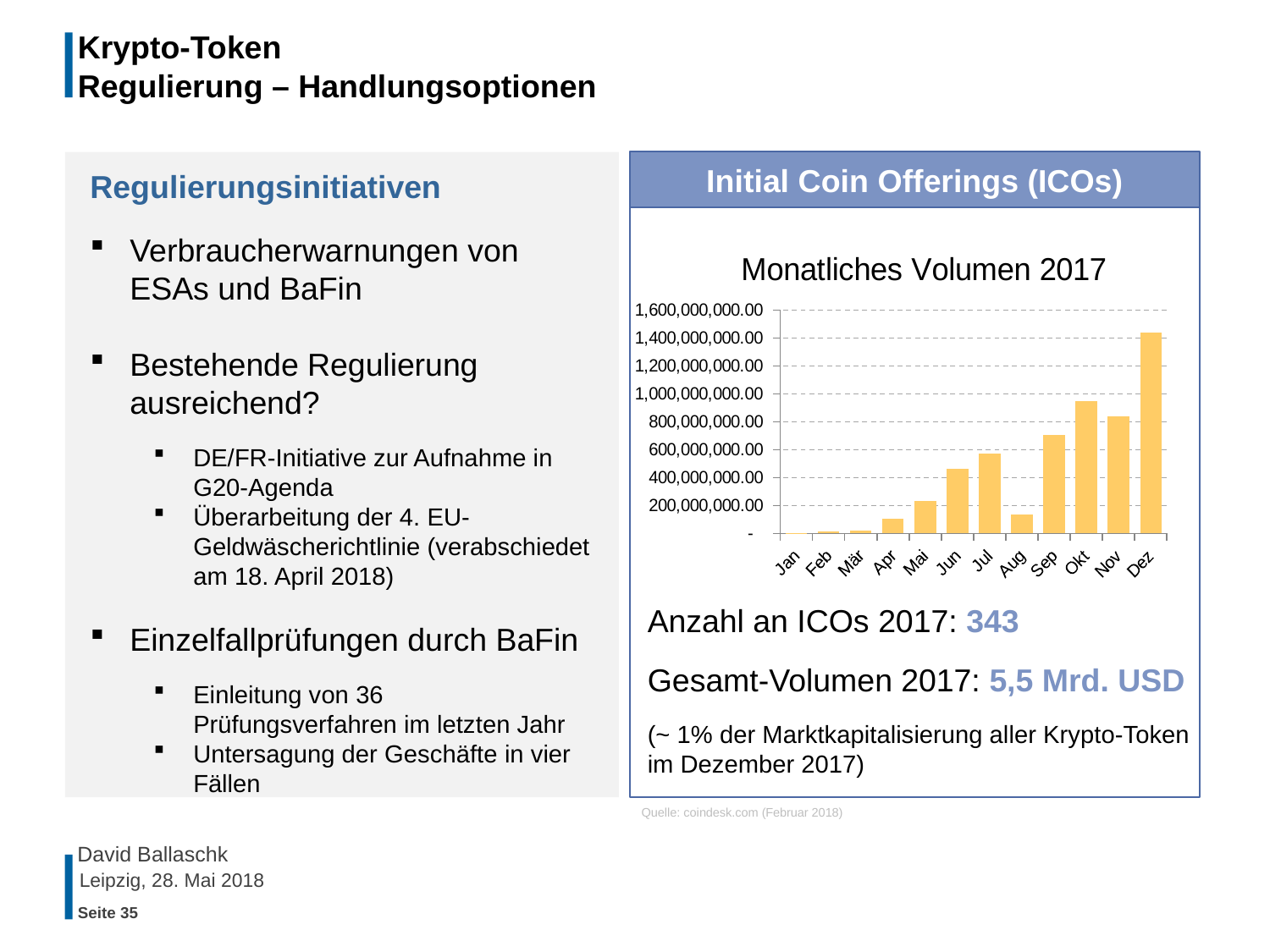
Is the value for Dez in the "Monatliches Volumen 2017" chart greater or less than 1,200,000,000.00? greater Is the value for Jun in the "Monatliches Volumen 2017" chart greater or less than 400,000,000.00? greater In the "Monatliches Volumen 2017" chart, which is larger, the value for Okt or the value for Nov? Okt How many months are plotted on the x axis of the "Monatliches Volumen 2017" chart? 12 Does the monthly volume in the "Monatliches Volumen 2017" chart generally rise or fall from Jan to Dez? rise Which month has the highest value in the "Monatliches Volumen 2017" chart? Dez Is the value for Aug in the "Monatliches Volumen 2017" chart greater or less than 200,000,000.00? less What is the title of the chart on the slide? Monatliches Volumen 2017 What kind of chart is shown under "Monatliches Volumen 2017"? bar chart In the "Monatliches Volumen 2017" chart, which is larger, the value for Jul or the value for Aug? Jul What is the highest value shown on the y axis of the "Monatliches Volumen 2017" chart? 1,600,000,000.00